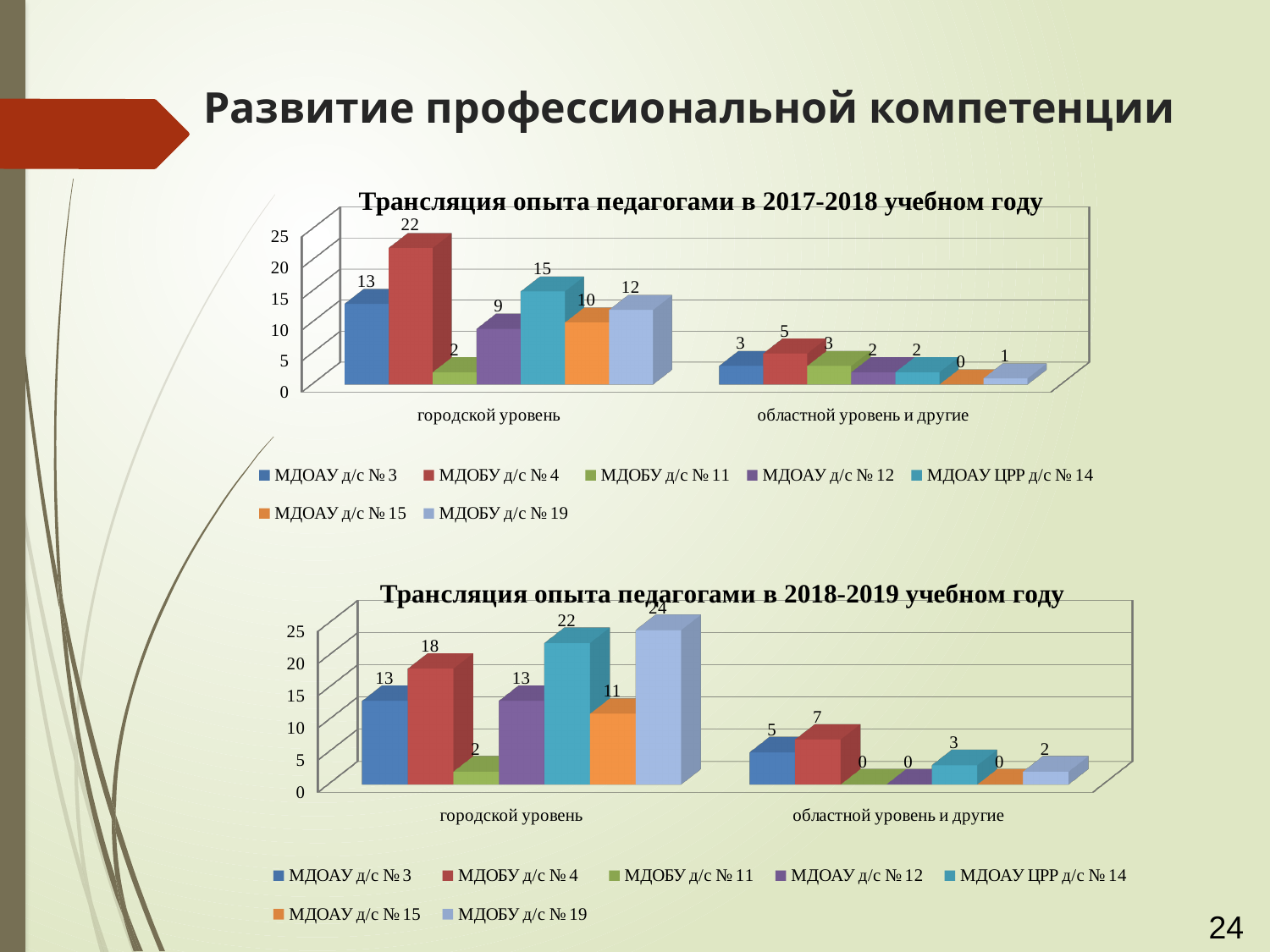
In the chart 'Трансляция опыта педагогами в 2017-2018 учебном году', what is the value for МДОБУ д/с № 4 at городской уровень? 22 How many categories are shown on the x axis of the bottom chart? 2 What kind of chart is the bottom chart on the slide? Bar chart In the chart 'Трансляция опыта педагогами в 2018-2019 учебном году', which is larger at городской уровень: МДОАУ ЦРР д/с № 14 or МДОБУ д/с № 4? МДОАУ ЦРР д/с № 14 In the chart 'Трансляция опыта педагогами в 2017-2018 учебном году', which series has the highest value at городской уровень? МДОБУ д/с № 4 How many series does the legend of the top chart list? 7 In the chart 'Трансляция опыта педагогами в 2018-2019 учебном году', what is the value for МДОБУ д/с № 19 at городской уровень? 24 In the chart 'Трансляция опыта педагогами в 2017-2018 учебном году', what is the difference between МДОБУ д/с № 4 and МДОАУ д/с № 3 at городской уровень? 9 In the chart 'Трансляция опыта педагогами в 2017-2018 учебном году', which series has the lowest value at областной уровень и другие? МДОАУ д/с № 15 In the chart 'Трансляция опыта педагогами в 2018-2019 учебном году', what is the value for МДОБУ д/с № 4 at областной уровень и другие? 7 In the chart 'Трансляция опыта педагогами в 2017-2018 учебном году', what is the value for МДОАУ ЦРР д/с № 14 at городской уровень? 15 In the chart 'Трансляция опыта педагогами в 2018-2019 учебном году', which series has the highest value at городской уровень? МДОБУ д/с № 19